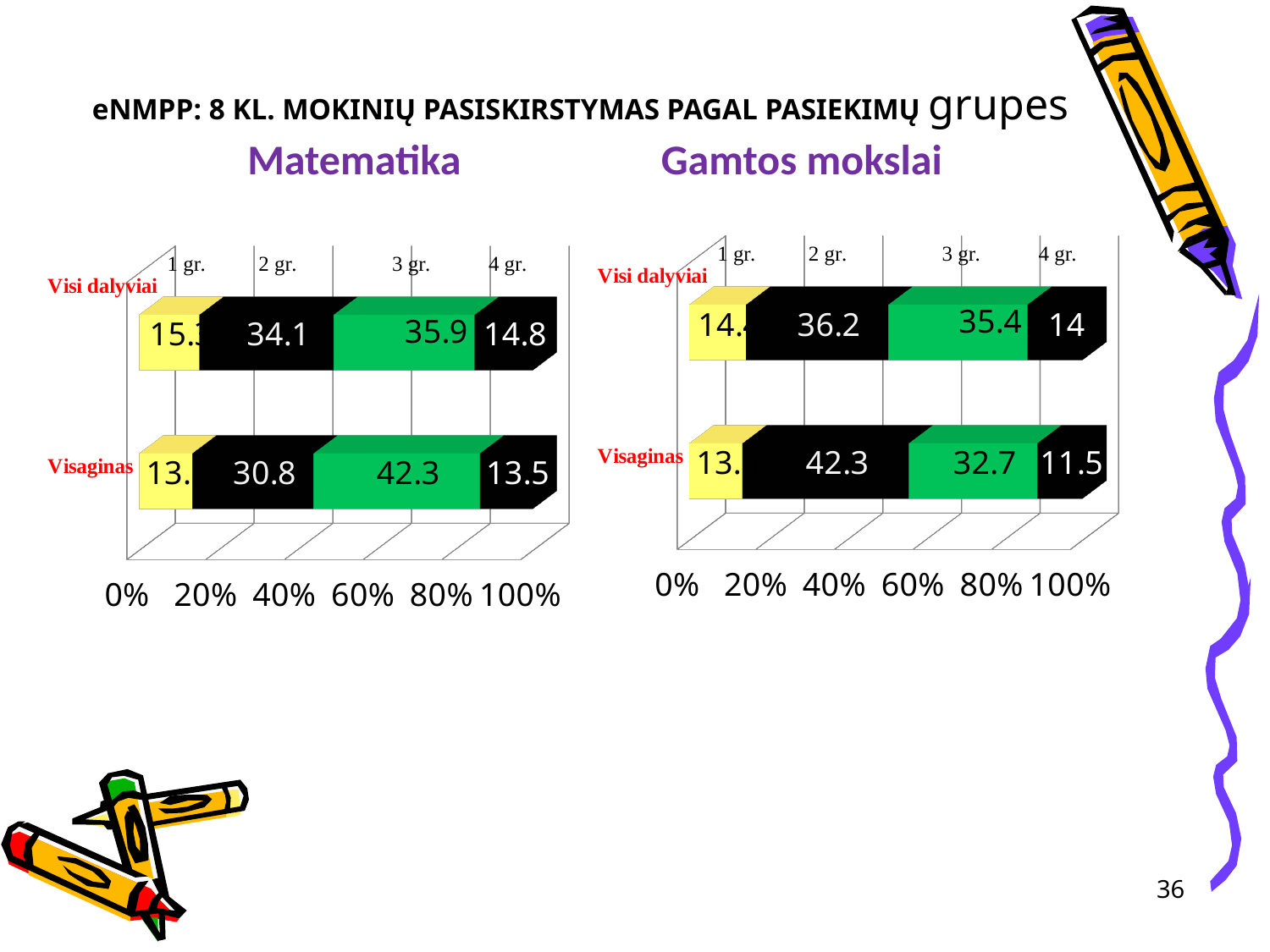
In the Gamtos mokslai chart, what is the value for 4 gr. for Visaginas? 11.5 In the Matematika chart, what is the difference between the 3 gr. values for Visaginas and Visi dalyviai? 6.4 In the Matematika chart, what is the value for 3 gr. for Visaginas? 42.3 In the Gamtos mokslai chart, what is the value for 2 gr. for Visaginas? 42.3 In the Gamtos mokslai chart, what is the value for 3 gr. for Visi dalyviai? 35.4 In the Matematika chart, which is larger for Visaginas: the 2 gr. value or the 3 gr. value? 3 gr. In the Matematika chart, what is the value for 4 gr. for Visi dalyviai? 14.8 In the Matematika chart, what is the value for 2 gr. for Visi dalyviai? 34.1 What kind of chart is the Gamtos mokslai chart? Stacked bar chart In the Gamtos mokslai chart, what is the difference between the 2 gr. values for Visaginas and Visi dalyviai? 6.1 In the Gamtos mokslai chart, which group has the largest value for Visaginas? 2 gr.